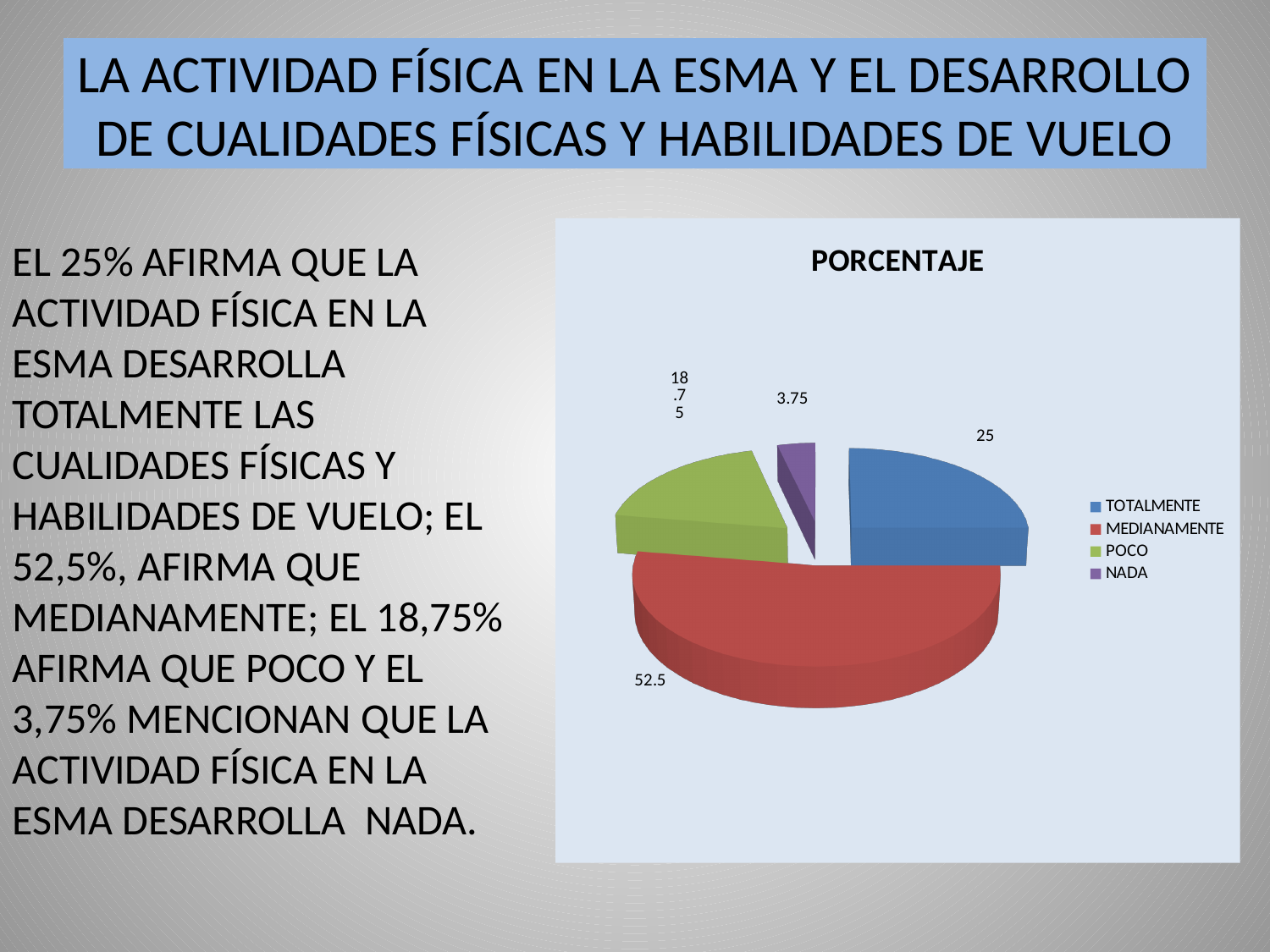
Which category has the largest slice of the pie? MEDIANAMENTE What is the value shown for POCO? 18.75 How many categories does the legend list? 4 What is the value shown for TOTALMENTE? 25 What is the title of the chart? PORCENTAJE What is the value shown for MEDIANAMENTE? 52.5 What is the difference between the values for MEDIANAMENTE and TOTALMENTE? 27.5 What colour is the slice for MEDIANAMENTE? red What type of chart is shown on the slide? pie chart Which category has the smallest slice of the pie? NADA Which is larger, the value for POCO or the value for TOTALMENTE? TOTALMENTE What is the value shown for NADA? 3.75